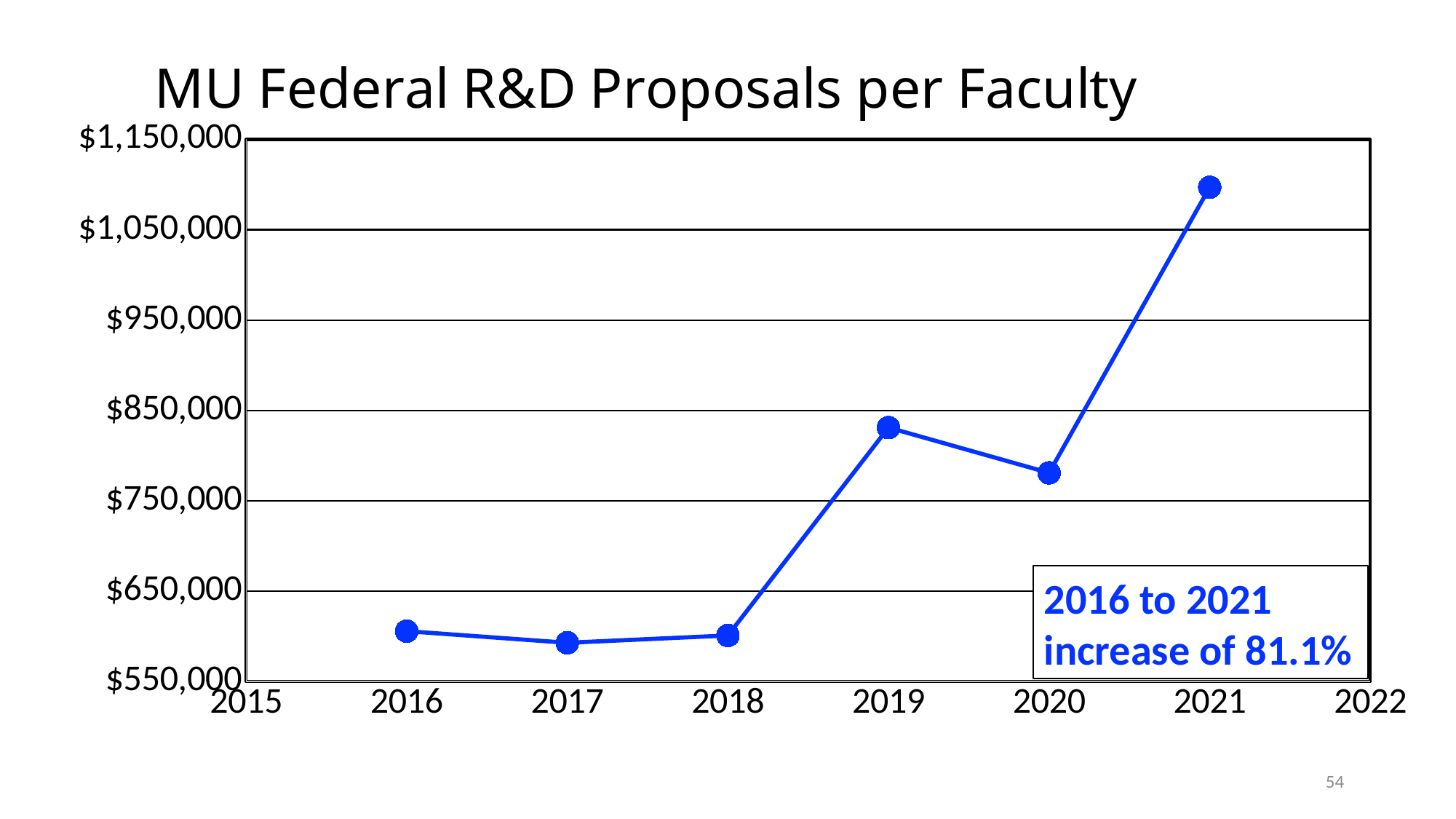
What kind of chart is shown on the slide? line chart Which year has the larger value, 2019 or 2020? 2019 Is the value for 2020 greater or less than $850,000? less Is the value for 2021 greater or less than $1,050,000? greater Is the value for 2019 greater or less than $750,000? greater How many data points are plotted on the line? 6 Which year has the highest value? 2021 According to the annotation on the chart, what is the percentage increase from 2016 to 2021? 81.1% What is the title of the chart? MU Federal R&D Proposals per Faculty Overall, do the values rise or fall from 2016 to 2021? rise